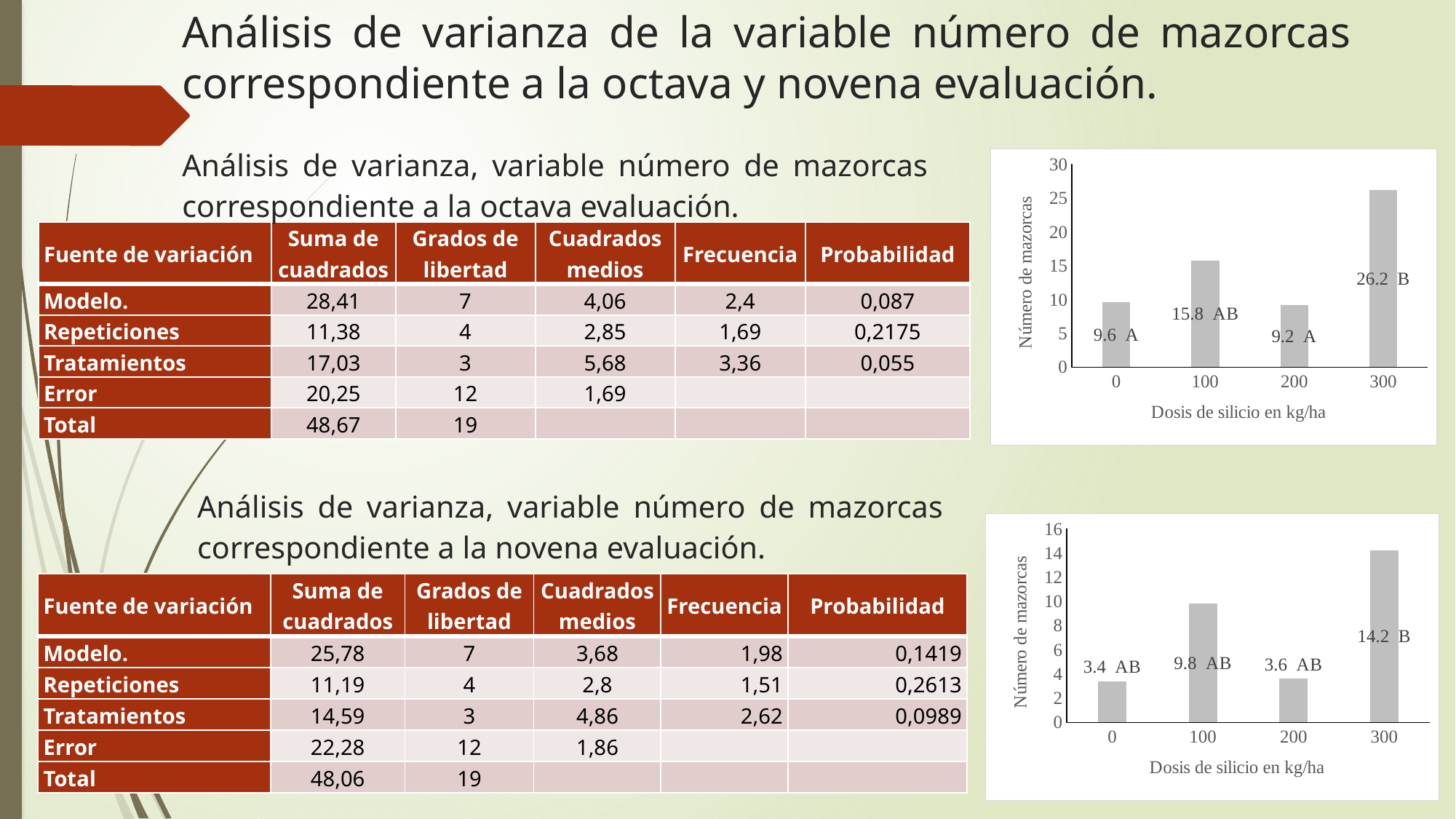
In the bottom-right chart, which silicon dose has the highest number of mazorcas? 300 In the bottom-right chart, what is the difference between the values for 100 kg/ha and 0 kg/ha? 6.4 In the top-right chart, how many silicon doses are plotted? 4 What kind of chart is the bottom-right chart? bar chart In the top-right chart, what is the difference between the values for 300 kg/ha and 0 kg/ha? 16.6 In the top-right chart, what is the number of mazorcas for a silicon dose of 300 kg/ha? 26.2 In the top-right chart, which silicon dose has the lowest number of mazorcas? 200 In the bottom-right chart, what is the number of mazorcas for a silicon dose of 300 kg/ha? 14.2 In the bottom-right chart, what is the number of mazorcas for a silicon dose of 0 kg/ha? 3.4 In the top-right chart, what is the number of mazorcas for a silicon dose of 100 kg/ha? 15.8 In the top-right chart, which silicon dose has the highest number of mazorcas? 300 In the bottom-right chart, is the value for 100 kg/ha larger or smaller than the value for 200 kg/ha? larger